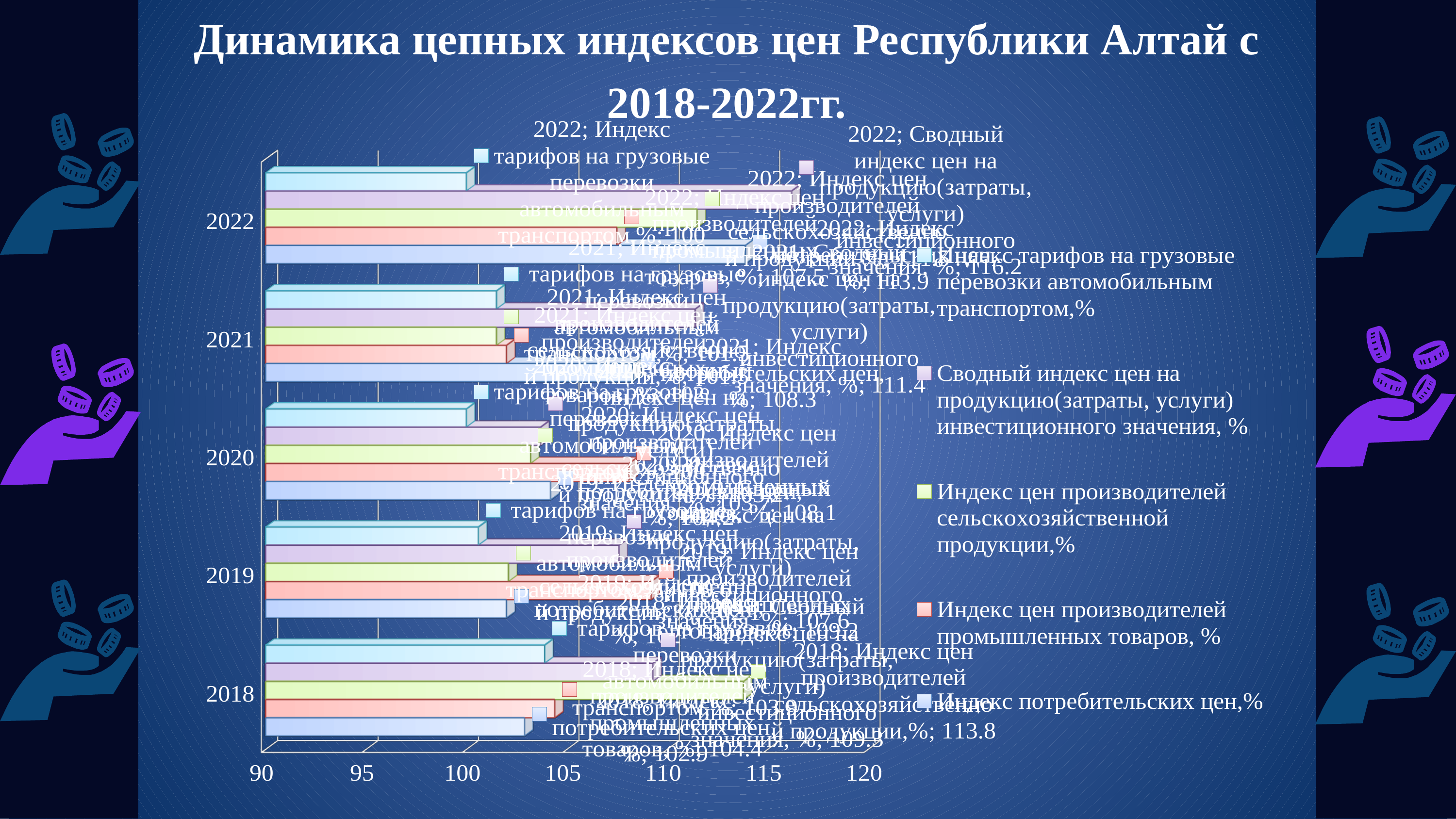
What is the value of the Индекс тарифов на грузовые перевозки автомобильным транспортом for 2022? 100 What is the value of the Сводный индекс цен на продукцию (затраты, услуги) инвестиционного значения for 2021? 111.4 How many series does the chart legend list? 5 How many years (categories) are shown on the vertical axis of the chart? 5 What is the title of the chart on the slide? Динамика цепных индексов цен Республики Алтай с 2018-2022гг. What is the highest value shown on the horizontal axis of the chart? 120 What is the difference between the Сводный индекс цен инвестиционного значения for 2022 and for 2021? 4.8 Is the value of the Индекс цен производителей сельскохозяйственной продукции for 2018 greater or less than 110? greater Which series has the lowest value for 2022? Индекс тарифов на грузовые перевозки автомобильным транспортом,% What is the value of the Индекс цен производителей сельскохозяйственной продукции for 2018? 113.8 What is the value of the Сводный индекс цен на продукцию (затраты, услуги) инвестиционного значения for 2022? 116.2 What kind of chart is shown on the slide? bar chart